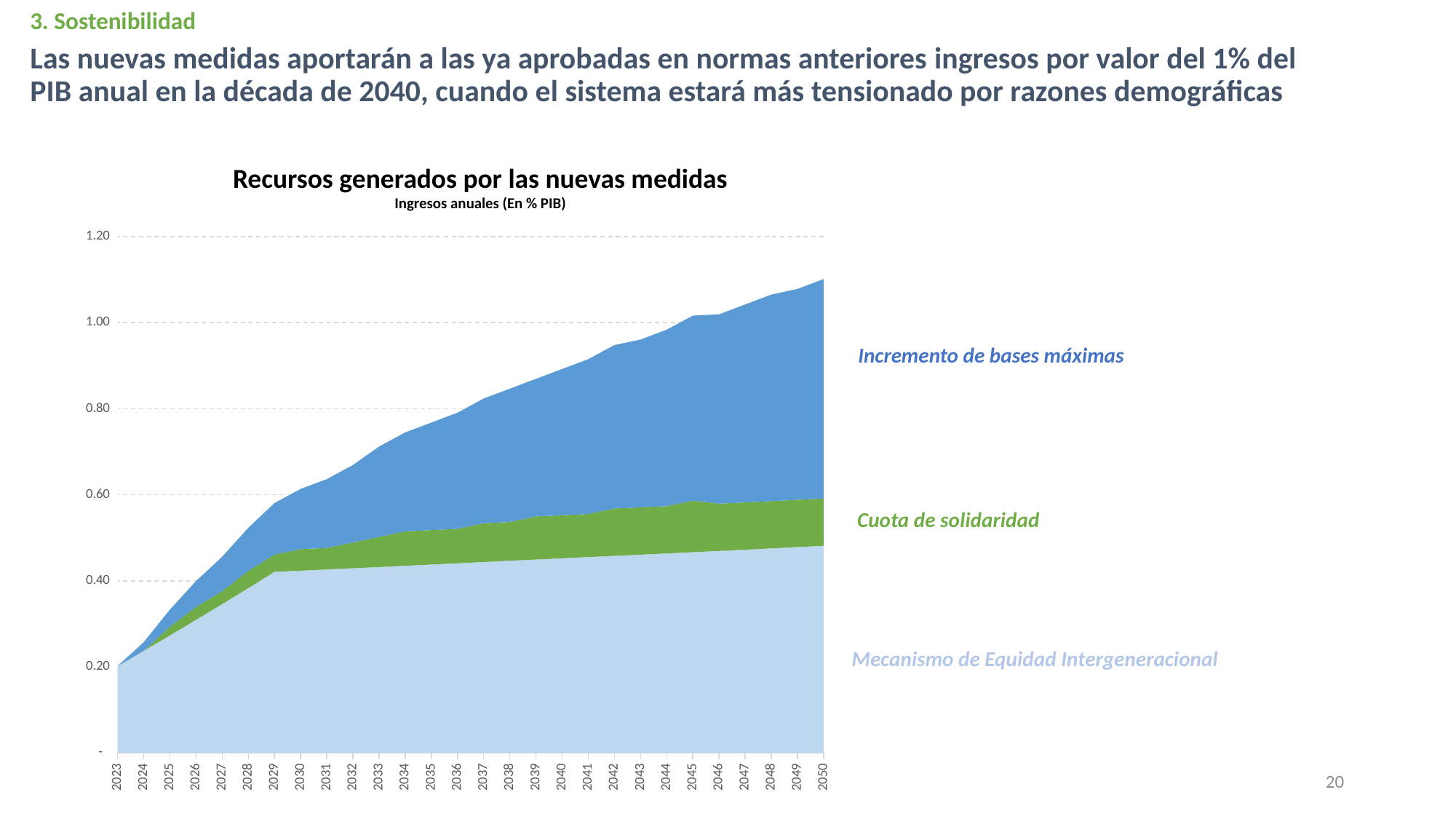
What is the last year shown on the x axis? 2050 Is the total value for 2030 greater or less than 0.80? less Which colour represents Cuota de solidaridad in the chart? Green How many years are shown on the x axis of the chart? 28 Do the total resources generated rise or fall from 2023 to 2050? Rise What is the first year shown on the x axis? 2023 Is the total value for 2050 greater or less than 1.00? greater Which series contributes the smallest amount in 2050? Cuota de solidaridad What kind of chart is shown on the slide? Stacked area chart Is the value for Mecanismo de Equidad Intergeneracional in 2050 greater or less than 0.60? less What is the title of the chart? Recursos generados por las nuevas medidas How many series does the chart show? 3